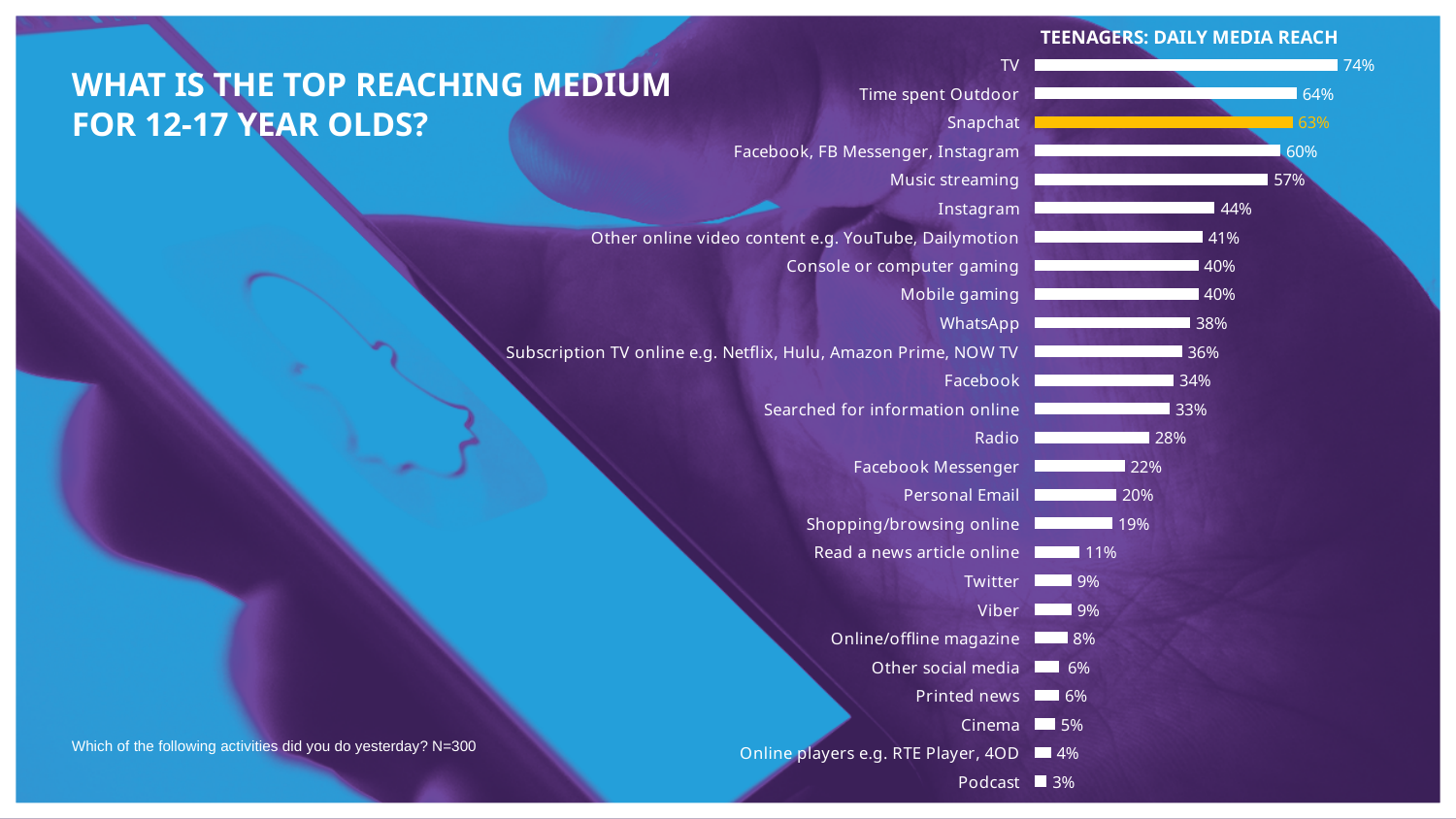
What is the daily reach value for Podcast? 3% Which has a higher daily reach, WhatsApp or Facebook? WhatsApp What is the difference between the daily reach of Music streaming and Instagram? 13% What is the daily reach value for TV? 74% Which medium has the highest daily reach? TV What is the daily reach value for Snapchat? 63% What type of chart is shown on the slide? Bar chart What is the difference between the daily reach of TV and Time spent Outdoor? 10% What is the daily reach value for Radio? 28% How many media categories are shown in the chart? 26 Which bar in the chart is highlighted in a different colour (yellow)? Snapchat Which medium has the lowest daily reach? Podcast